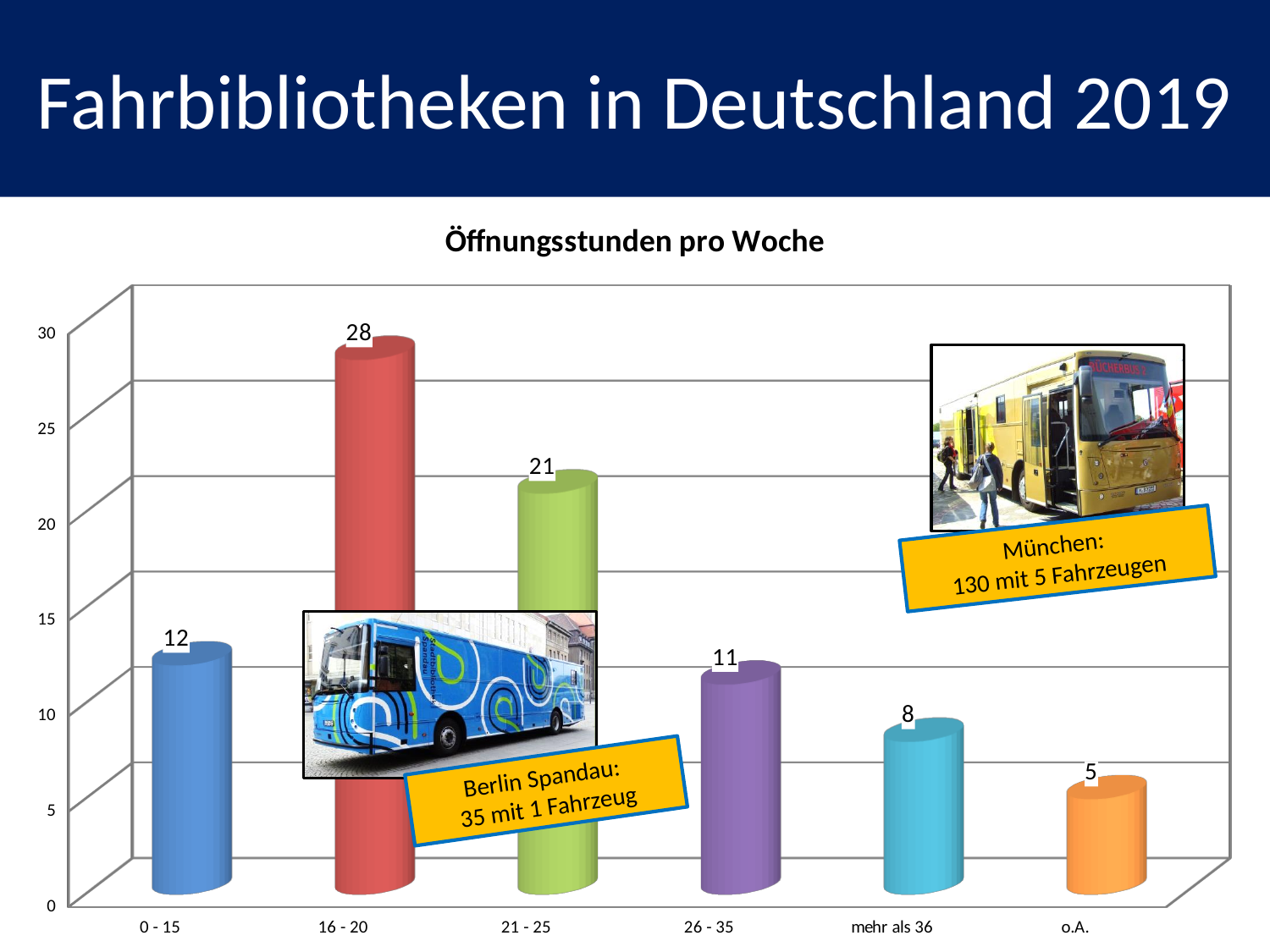
What is the difference between the values for "16 - 20" and "21 - 25"? 7 Which is larger, the value for "0 - 15" or the value for "26 - 35"? 0 - 15 What kind of chart is shown on the slide? bar chart What is the title of the chart? Öffnungsstunden pro Woche What is the value for the category "o.A."? 5 How many categories are shown on the x axis? 6 Which category has the highest value? 16 - 20 What is the value for the category "16 - 20"? 28 Which category has the lowest value? o.A. What is the value for the category "mehr als 36"? 8 What is the value for the category "0 - 15"? 12 Is the value for "21 - 25" greater or less than 20? greater